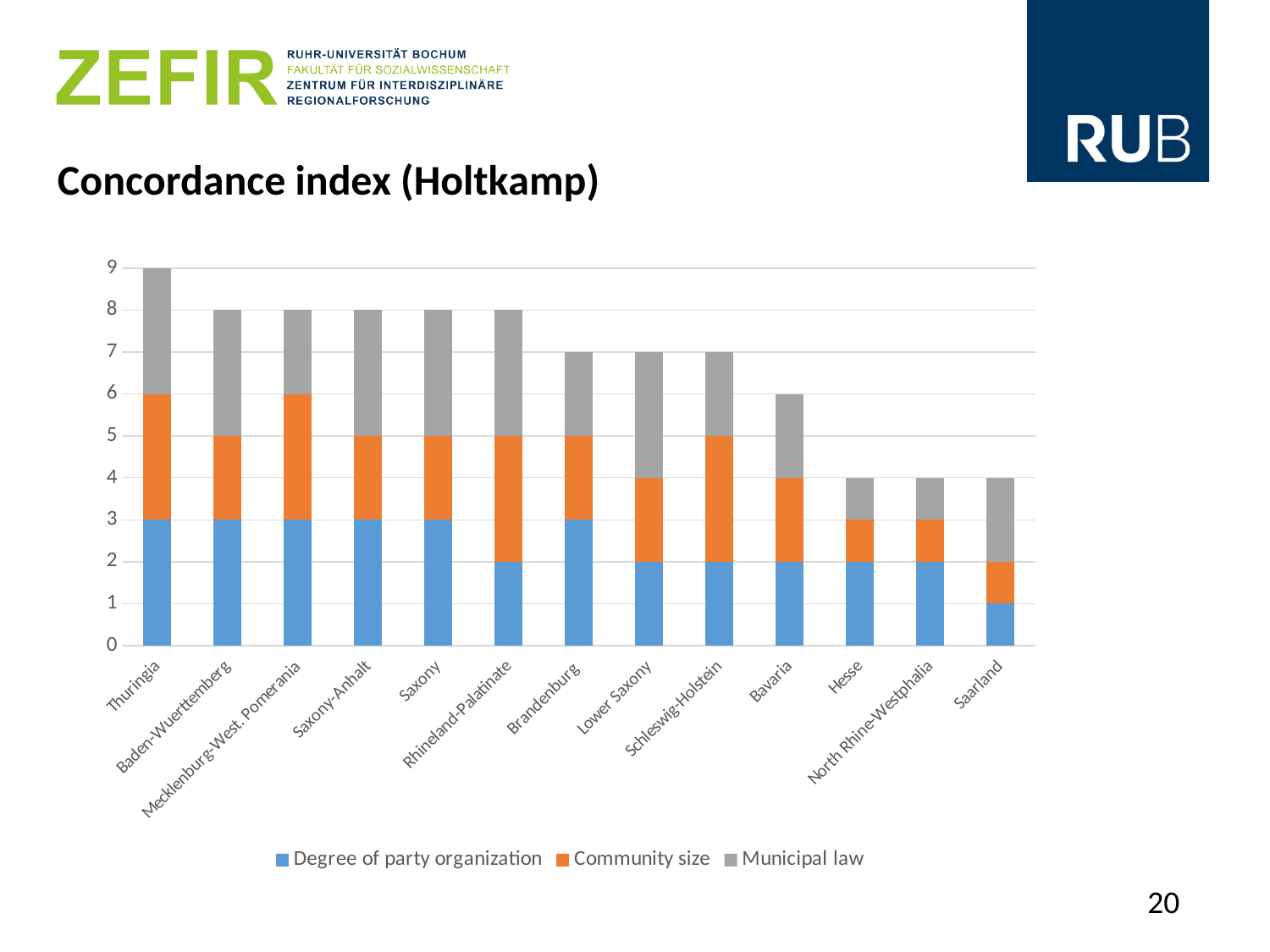
How many series does the legend list? 3 Which has a larger total, Brandenburg or Hesse? Brandenburg Which series is shown in orange in the legend? Community size How many federal states (categories) are shown on the x axis? 13 What type of chart is shown on the slide? stacked bar chart Do the total bar heights generally rise or fall from left to right along the x axis? fall Which state has the highest total concordance index? Thuringia What is the value of Degree of party organization for Thuringia? 3 What is the total stacked value for Bavaria? 6 What is the value of Degree of party organization for Saarland? 1 What is the total stacked value for Thuringia? 9 What is the difference between the total for Thuringia and the total for Saarland? 5